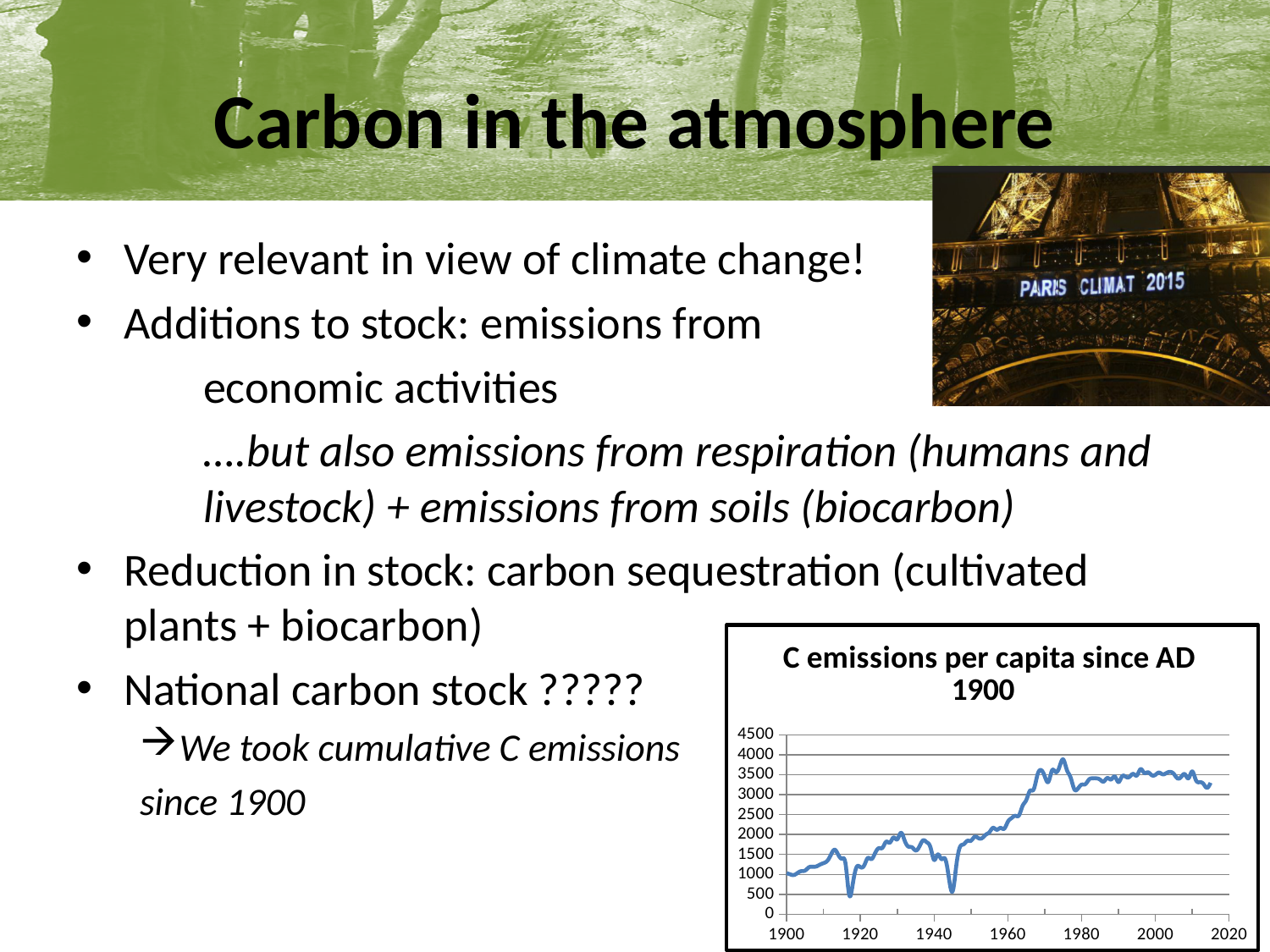
Is the value for 1960 greater or less than 2500? less Is the value for 1920 greater or less than 1500? less What kind of chart is shown on the slide? line chart Overall, do the values in the chart rise or fall from 1900 to 2020? rise Is the value for 2000 greater or less than 3000? greater What is the title of the chart on the slide? C emissions per capita since AD 1900 What is the highest value shown on the vertical axis of the chart? 4500 In which decade does the line reach its highest value? 1970s Which year has the larger value, 1900 or 1930? 1930 Which year has the larger value, 1960 or 2000? 2000